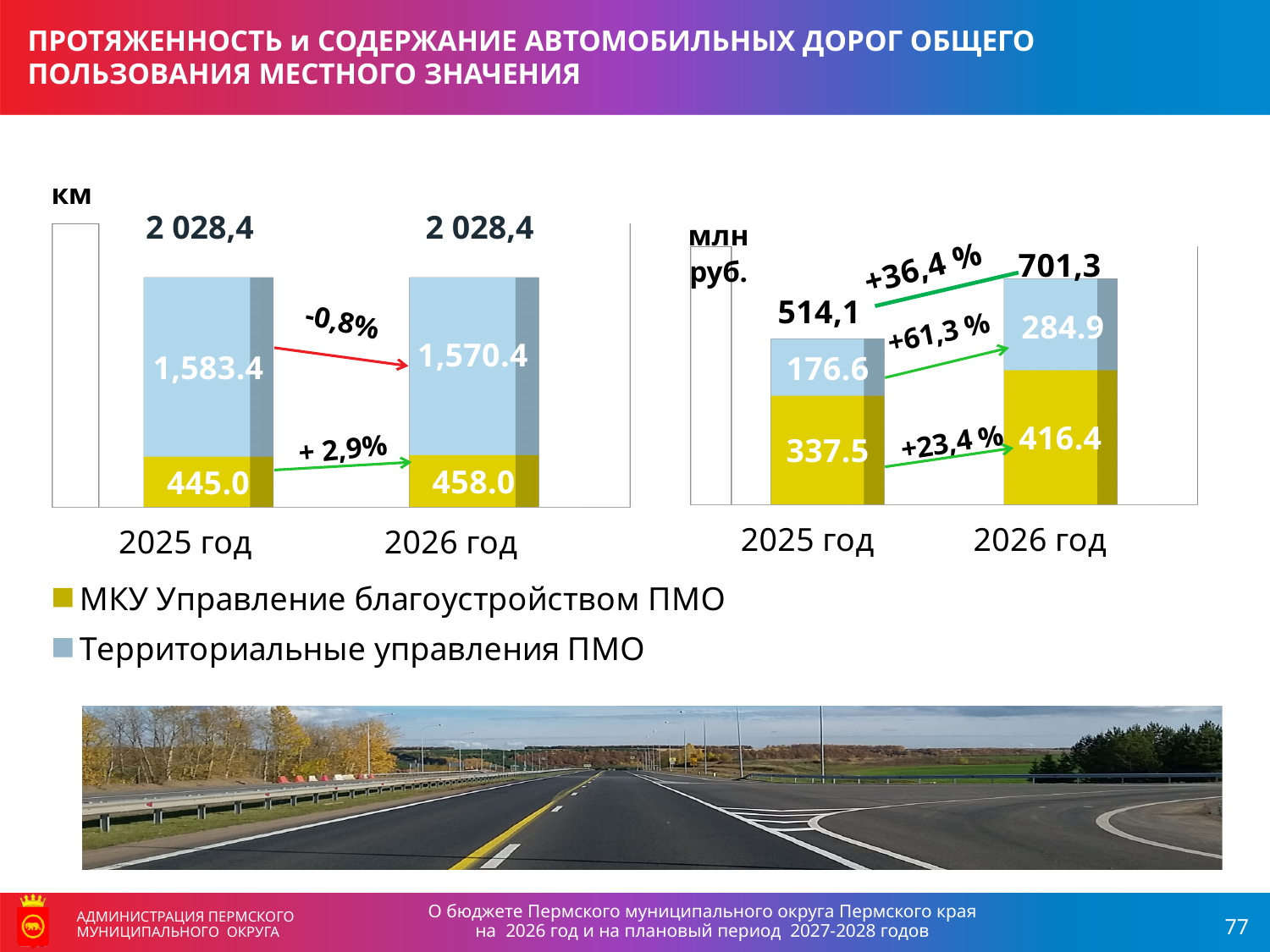
On the left chart (km), which is larger in 2025 год: Территориальные управления ПМО or МКУ Управление благоустройством ПМО? Территориальные управления ПМО On the right chart (млн руб.), what is the value for Территориальные управления ПМО in 2026 год? 284.9 On the right chart (млн руб.), which year has the higher total? 2026 год On the right chart (млн руб.), what percentage change is shown between the totals for 2025 год and 2026 год? +36,4 % On the right chart (млн руб.), what is the value for МКУ Управление благоустройством ПМО in 2025 год? 337.5 On the left chart (km), what is the value for МКУ Управление благоустройством ПМО in 2026 год? 458.0 On the right chart (млн руб.), what is the difference between the МКУ Управление благоустройством ПМО values for 2026 год and 2025 год? 78.9 On the left chart (km), what is the value for Территориальные управления ПМО in 2025 год? 1,583.4 How many series does the legend list? 2 On the right chart (млн руб.), what is the total shown above the 2026 год bar? 701,3 What kind of chart is the right chart (млн руб.)? Stacked bar chart On the left chart (km), what is the total shown above the 2026 год bar? 2 028,4